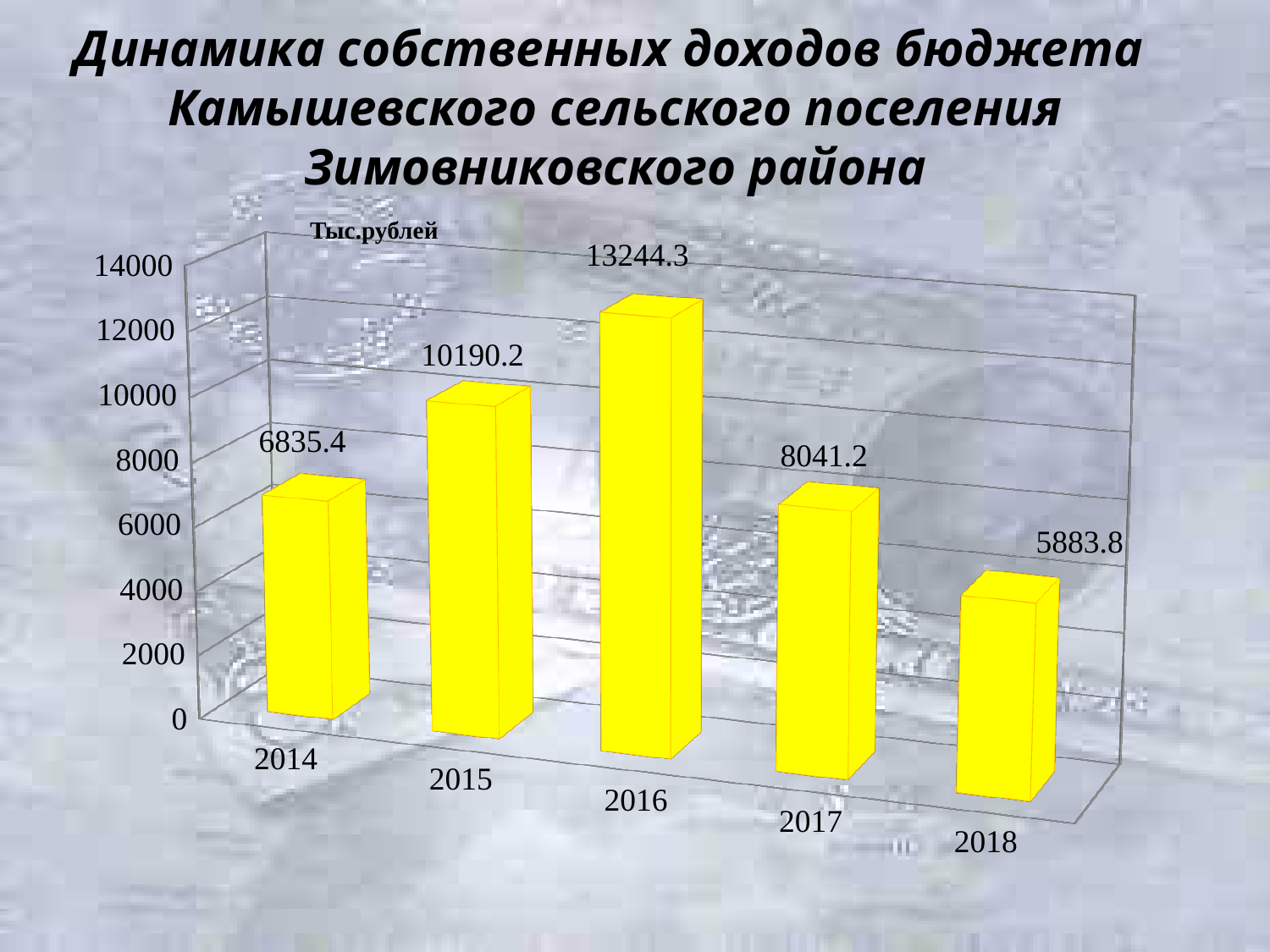
What is the difference between the values for 2017 and 2018? 2157.4 What is the value for 2016? 13244.3 Which year has the highest value? 2016 What is the value for 2018? 5883.8 What is the value for 2014? 6835.4 What kind of chart is shown on the slide? bar chart Is the value for 2015 greater or less than 10000? greater Which year has the lowest value? 2018 What is the difference between the values for 2016 and 2015? 3054.1 How many years are shown on the chart? 5 In what units are the values on the chart given? Тыс.рублей Which is larger, the value for 2015 or the value for 2017? 2015